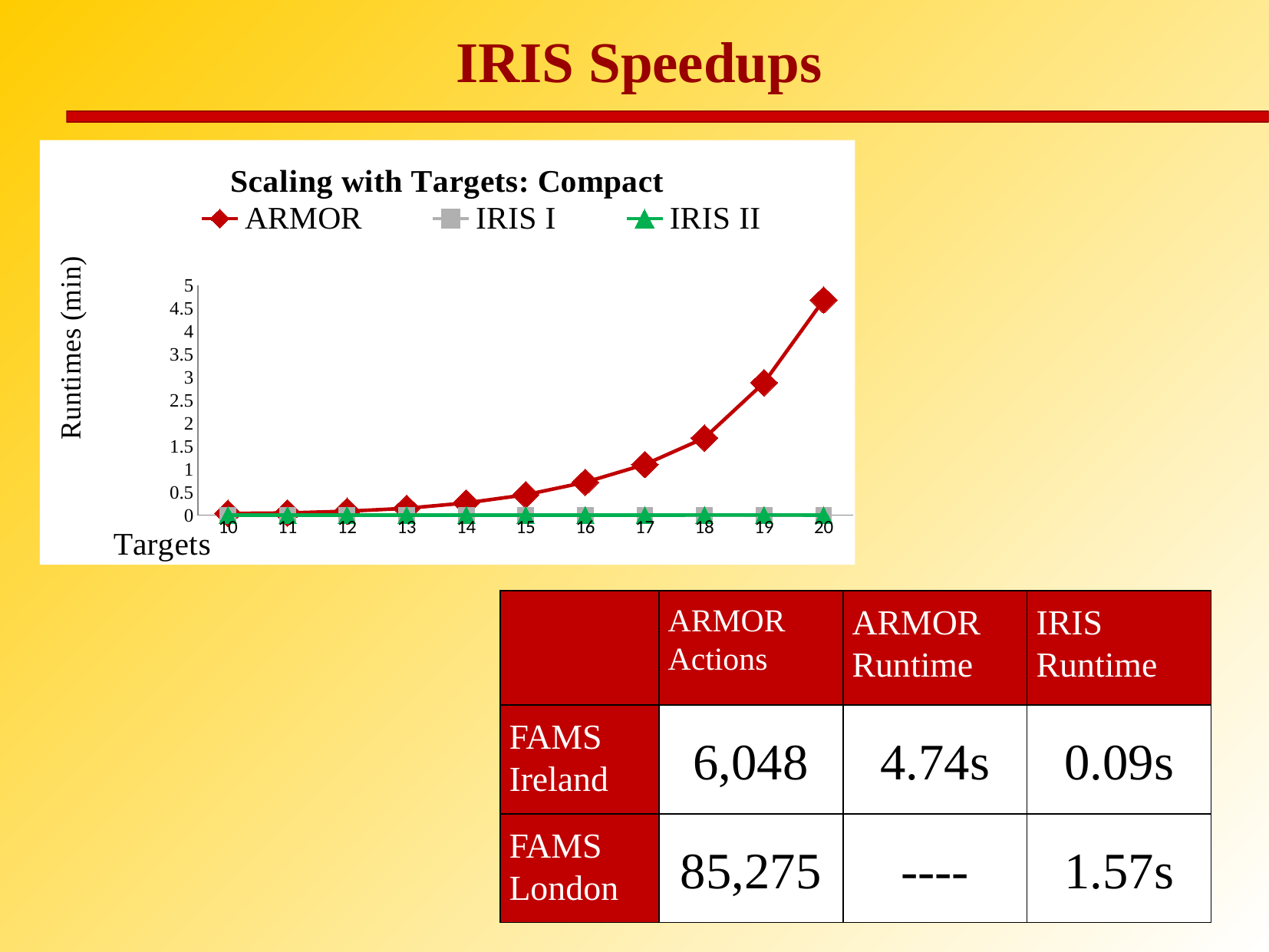
What kind of chart is shown on the slide? line chart Which series has the highest runtime at 20 targets? ARMOR How many target values are plotted along the x axis of the chart? 11 Is the ARMOR runtime at 16 targets greater or less than 0.5 minutes? greater What is the title of the chart? Scaling with Targets: Compact Does the ARMOR runtime rise or fall as the number of targets increases from 10 to 20? rise Is the ARMOR runtime at 20 targets greater or less than 4 minutes? greater Is the ARMOR runtime at 15 targets greater or less than 1 minute? less Which series are listed in the chart legend? ARMOR, IRIS I, IRIS II At 18 targets, which series has the larger runtime, ARMOR or IRIS II? ARMOR How many series does the chart legend list? 3